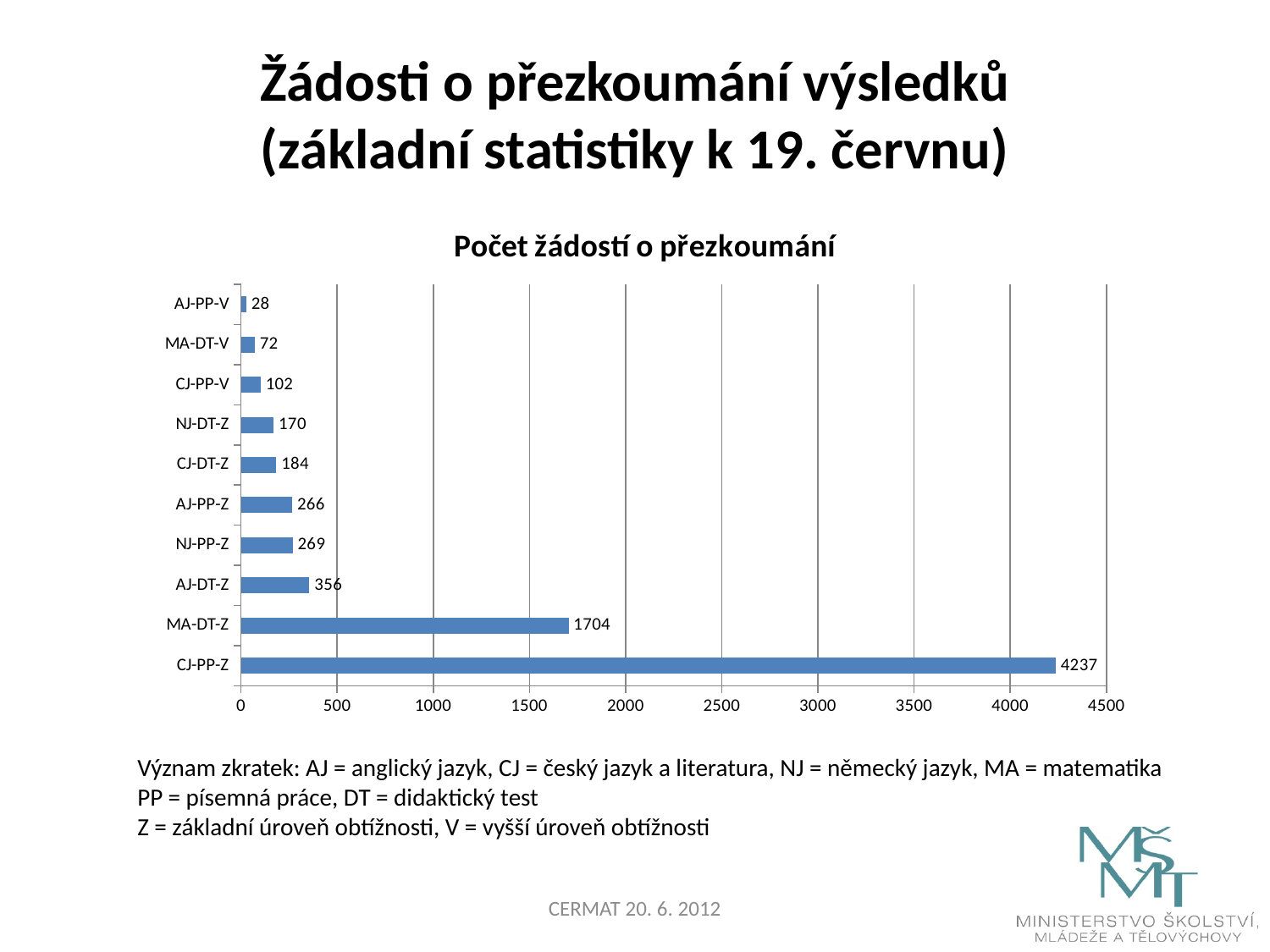
What is the value for AJ-PP-V? 28 What kind of chart is shown on the slide? bar chart What is the value for MA-DT-Z? 1704 What is the value for NJ-DT-Z? 170 What is the difference between the values for CJ-PP-Z and MA-DT-Z? 2533 Is the value for MA-DT-Z greater or less than 1500? greater What is the title of the chart? Počet žádostí o přezkoumání How many categories are shown in the chart? 10 Which category has the highest value? CJ-PP-Z What is the value for CJ-PP-Z? 4237 Which category has the lowest value? AJ-PP-V Which is larger, the value for AJ-DT-Z or the value for CJ-DT-Z? AJ-DT-Z